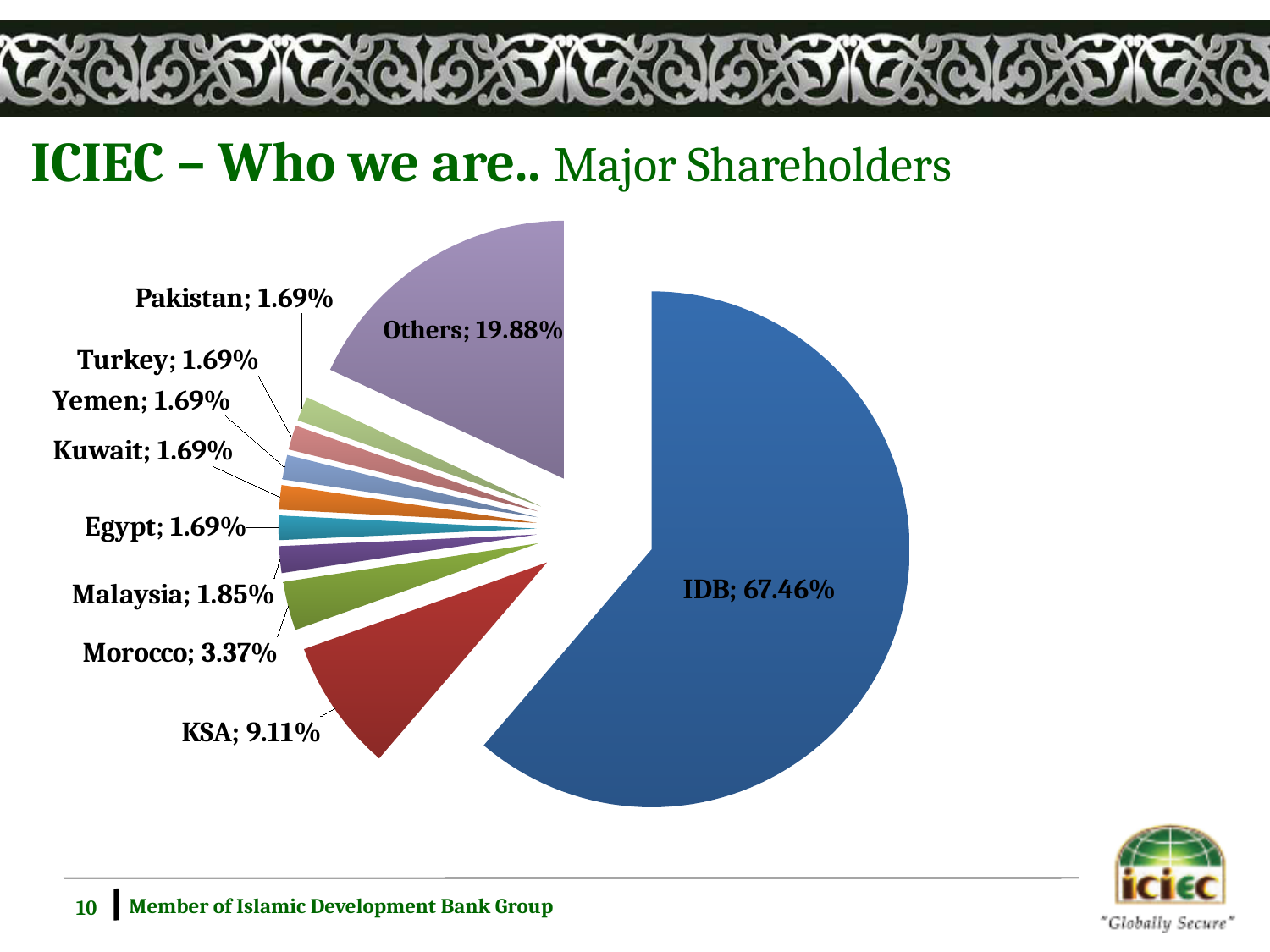
What share of the pie does IDB hold? 67.46% What is the value shown for Others? 19.88% Which shareholder has the largest slice of the pie? IDB What is the value shown for Morocco? 3.37% Which is larger, the share for Morocco or the share for Malaysia? Morocco What is the difference between the IDB share and the KSA share? 58.35% What is the value shown for KSA? 9.11% What is the value shown for Egypt? 1.69% How many slices does the pie chart have? 10 What kind of chart is shown on the slide? pie chart What is the title of the slide containing the chart? ICIEC – Who we are.. Major Shareholders What is the value shown for Malaysia? 1.85%